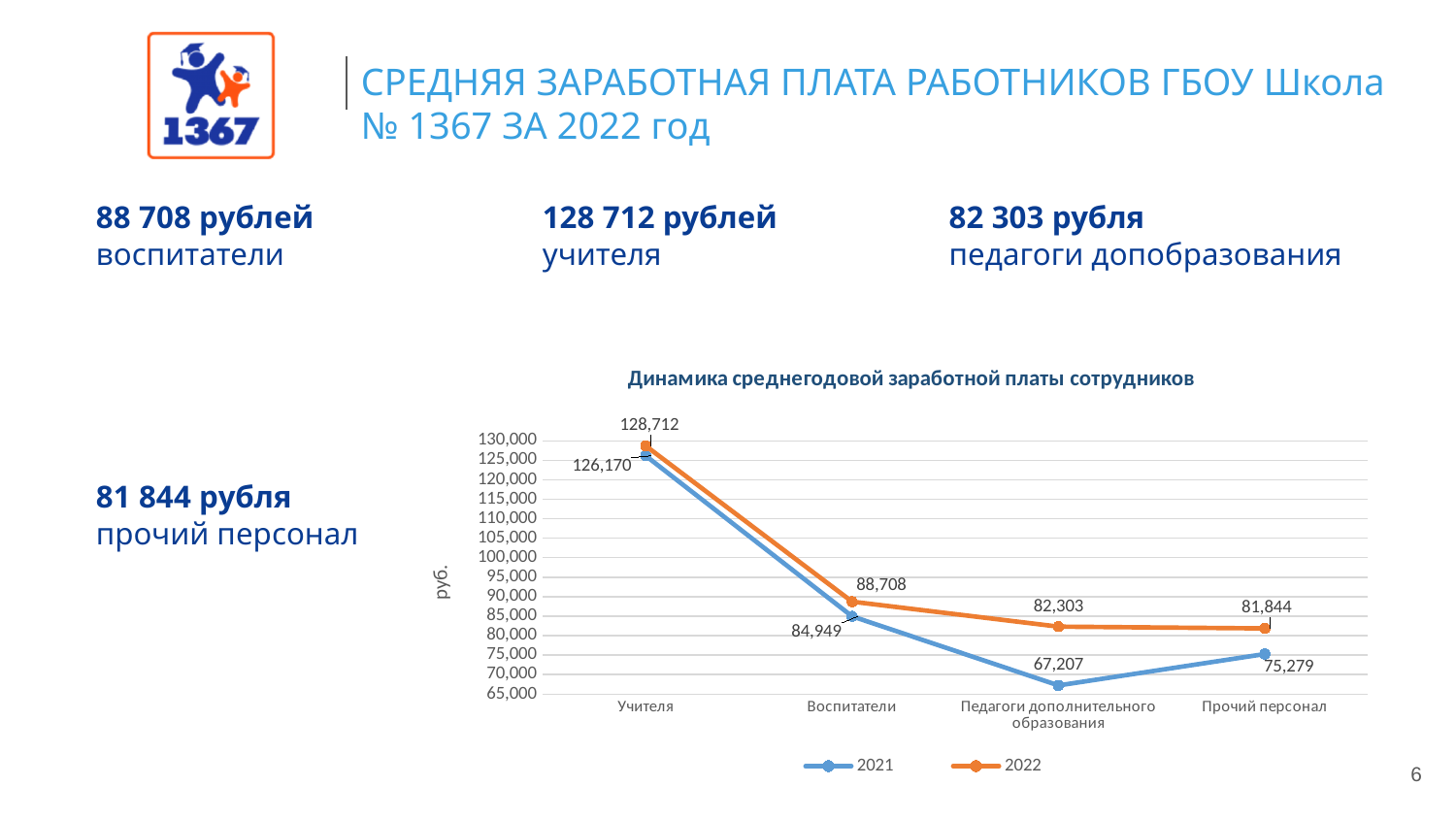
What is the title of the chart? Динамика среднегодовой заработной платы сотрудников Does the 2021 series rise or fall from Учителя to Педагоги дополнительного образования? fall Which is larger for Педагоги дополнительного образования: the 2021 value or the 2022 value? 2022 What is the difference between the 2022 and 2021 values for Воспитатели? 3,759 What is the 2021 value for Педагоги дополнительного образования? 67,207 How many series does the chart legend list? 2 How many categories are shown on the x axis of the chart? 4 What is the 2022 value for Учителя? 128,712 What is the 2021 value for Прочий персонал? 75,279 Which category has the lowest value in the 2021 series? Педагоги дополнительного образования What type of chart is shown on the slide? line chart Which category has the highest value in the 2022 series? Учителя